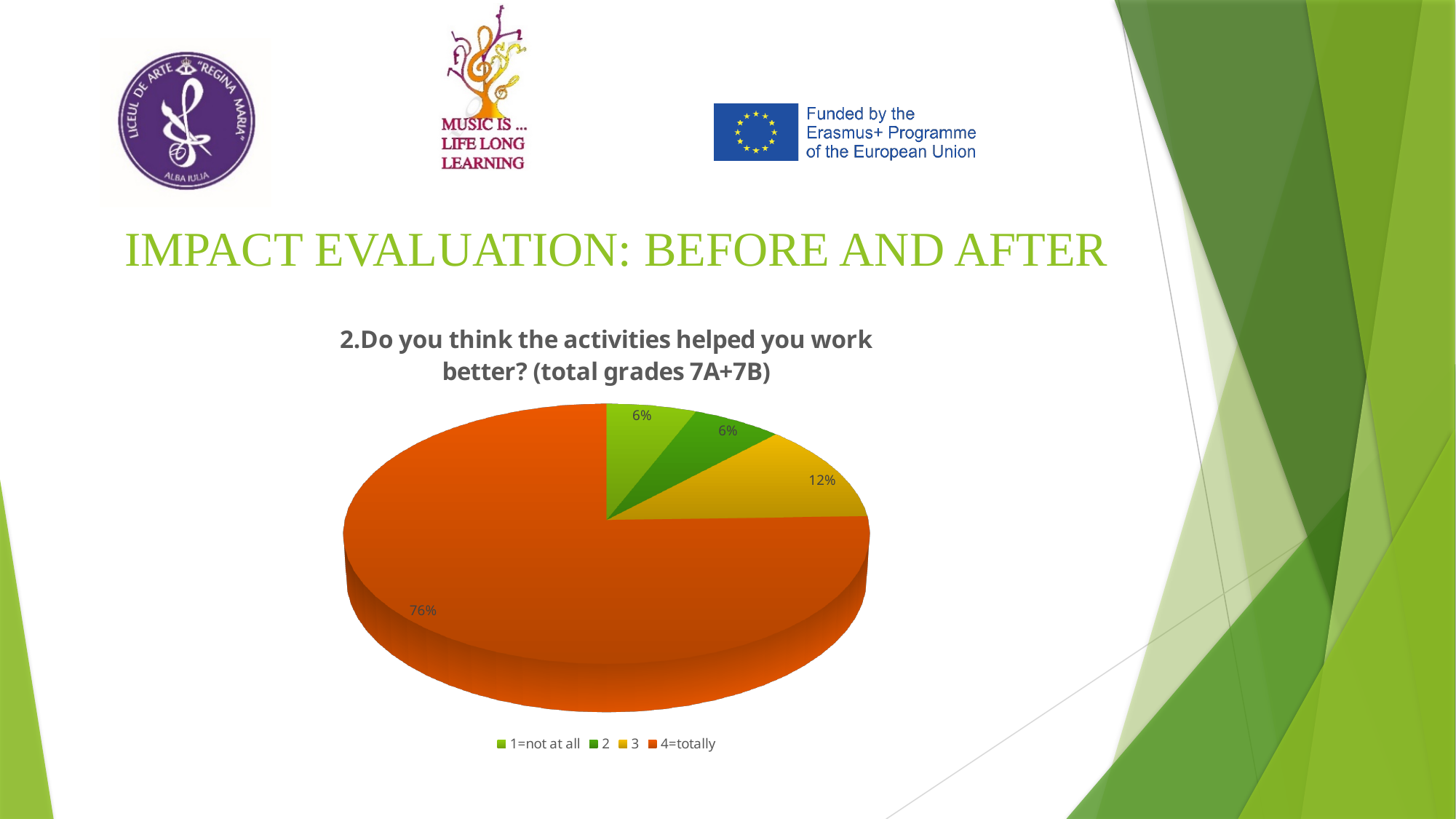
How many categories does the legend list? 4 What is the title of the chart? 2.Do you think the activities helped you work better? (total grades 7A+7B) Which is larger, the slice for "3" or the slice for "2"? 3 Which category has the largest slice of the pie? 4=totally What share of the pie does "4=totally" take? 76% What kind of chart is shown on the slide? pie chart What share of the pie does "3" take? 12% What colour is the slice for "4=totally"? orange What share of the pie does "2" take? 6% What is the difference in percentage points between "4=totally" and "3"? 64 What is the combined share of "1=not at all" and "2"? 12%